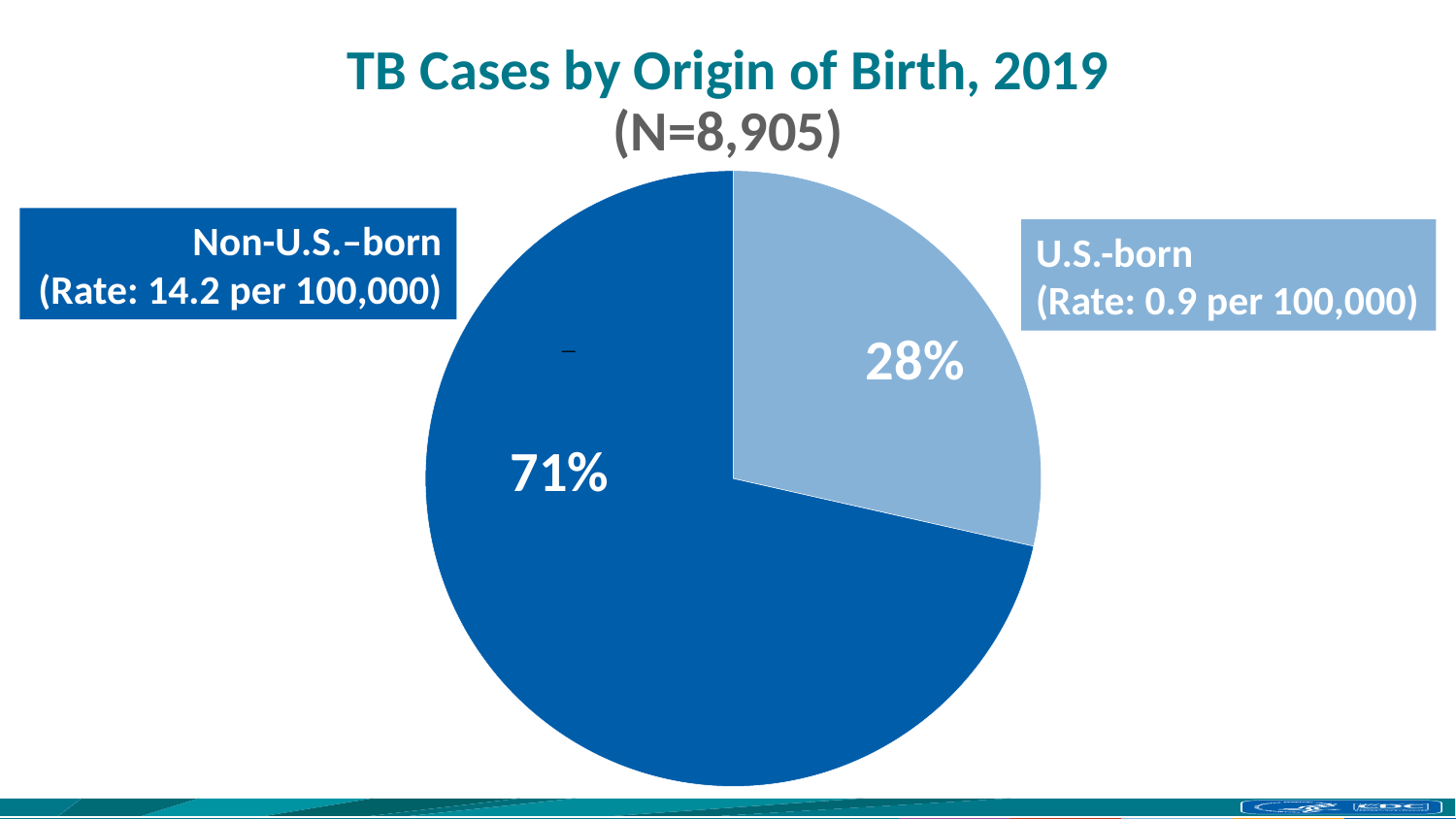
How many slices does the pie chart have? 2 What is the difference in percentage points between the Non-U.S.-born and U.S.-born slices? 43 Which is larger, the U.S.-born slice or the Non-U.S.-born slice? Non-U.S.-born What share of TB cases is U.S.-born? 28% What TB rate per 100,000 is given for the Non-U.S.-born category? 14.2 per 100,000 What share of TB cases is Non-U.S.-born? 71% What kind of chart is shown on the slide? pie chart Which category has the smallest slice of the pie? U.S.-born What is the title of the chart? TB Cases by Origin of Birth, 2019 What is the total number of TB cases (N) given in the chart title? 8,905 Which category has the largest slice of the pie? Non-U.S.-born What TB rate per 100,000 is given for the U.S.-born category? 0.9 per 100,000